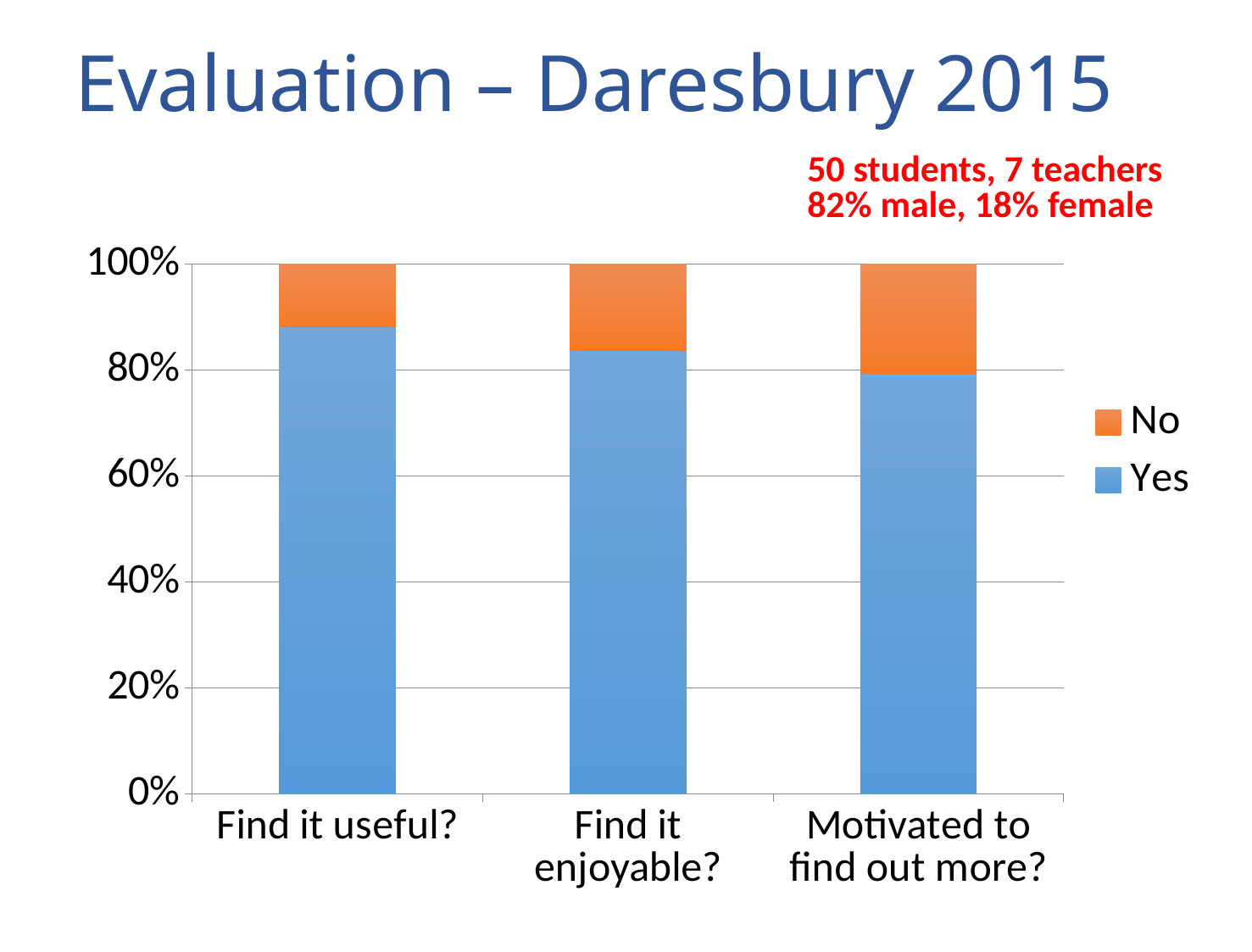
Is the 'Yes' value for 'Find it useful?' greater or less than 80%? greater How many series does the chart's legend list? 2 What kind of chart is shown on the slide? bar chart Which is larger: the 'Yes' share for 'Find it useful?' or for 'Motivated to find out more?'? Find it useful? Is the 'No' value for 'Find it enjoyable?' greater or less than 20%? less Does the 'Yes' share rise or fall moving from left to right across the categories? fall What colour represents the 'No' series in the chart? orange Which category has the highest 'Yes' share? Find it useful? How many categories are shown on the x axis of the chart? 3 Is the 'Yes' value for 'Motivated to find out more?' greater or less than 60%? greater Which category has the lowest 'Yes' share? Motivated to find out more? Which category has the largest 'No' share? Motivated to find out more?